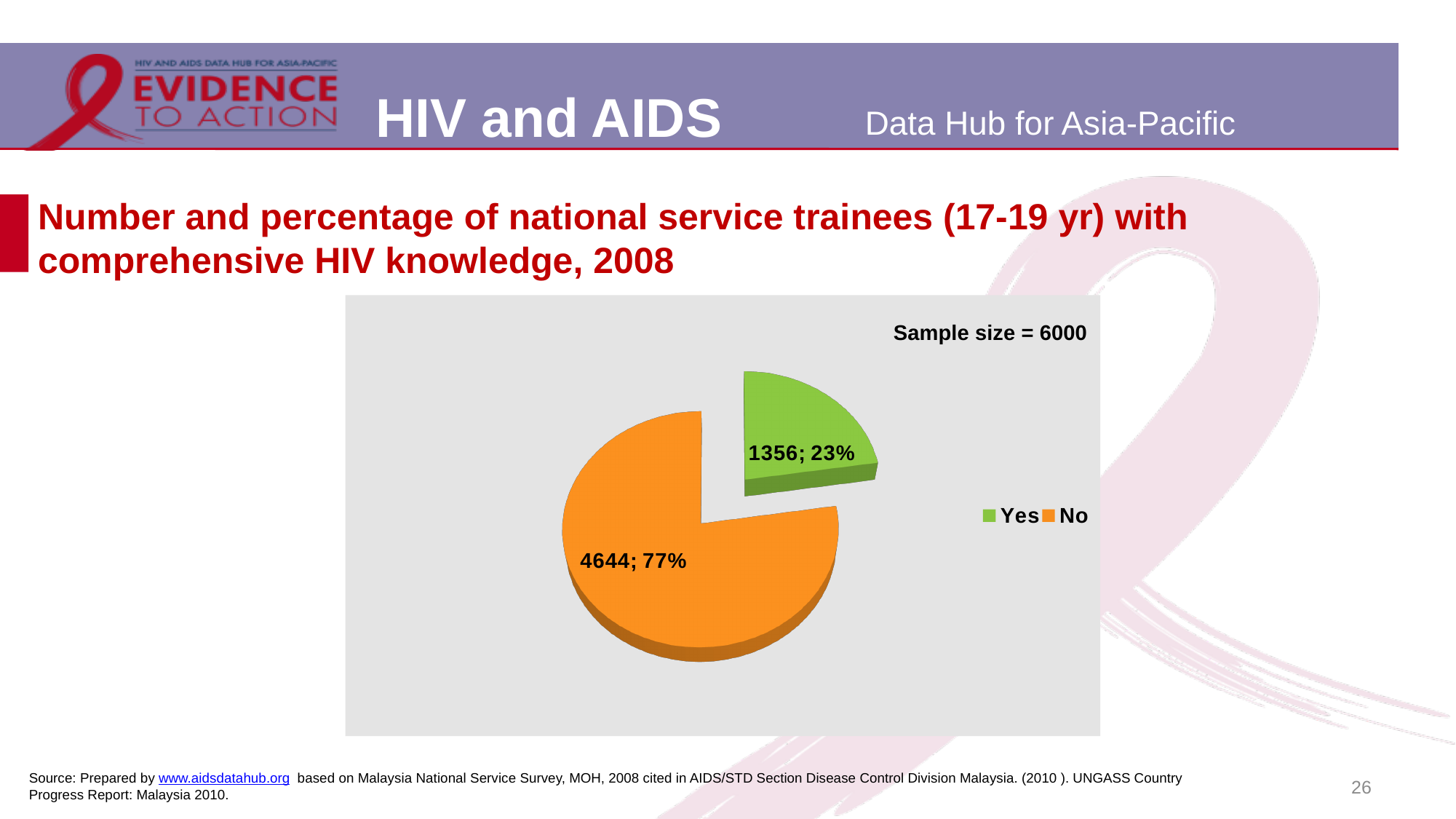
Which category has the smallest slice of the pie? Yes What percentage of trainees is shown for the No slice? 77% What kind of chart is shown on the slide? pie chart How many entries does the legend list? 2 How many trainees answered Yes to having comprehensive HIV knowledge? 1356 How many trainees answered No? 4644 What percentage of trainees is shown for the Yes slice? 23% What is the total number of trainees across both slices? 6000 What is the difference in number of trainees between the No and Yes slices? 3288 Which category has the larger slice, Yes or No? No How many slices does the pie chart have? 2 What sample size is stated on the chart? 6000